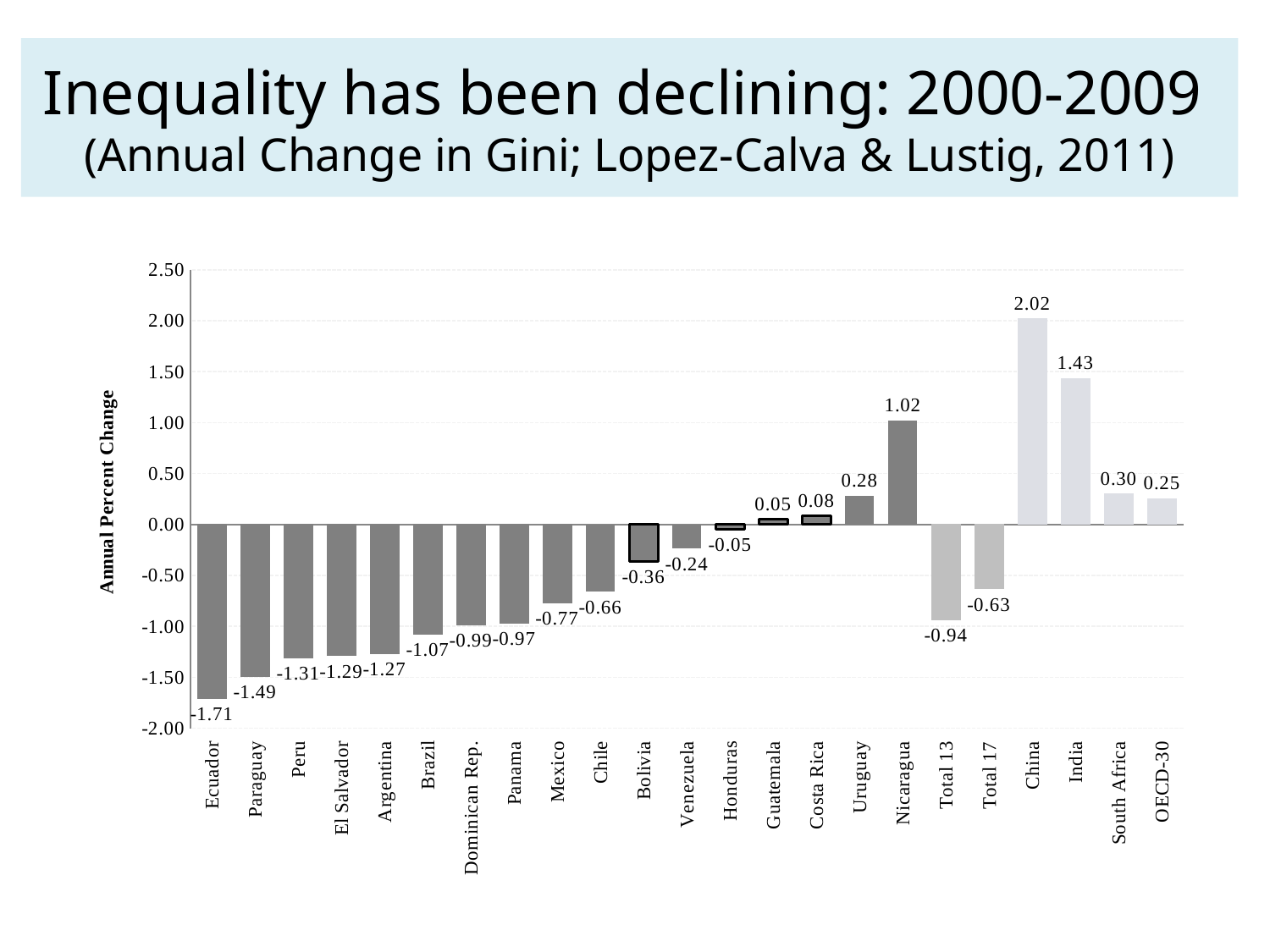
What value is shown for Nicaragua? 1.02 How many categories are plotted on the chart? 23 What is the label on the vertical axis of the chart? Annual Percent Change What kind of chart is shown on the slide? Bar chart Is the value for Paraguay greater or less than -1.00? less Which has a larger value, South Africa or OECD-30? South Africa Which category has the highest value on the chart? China Which category has the lowest value on the chart? Ecuador What value is shown for China? 2.02 What is the annual percent change in Gini shown for Ecuador? -1.71 What value is shown for Total 17? -0.63 What is the difference between the values for China and India? 0.59